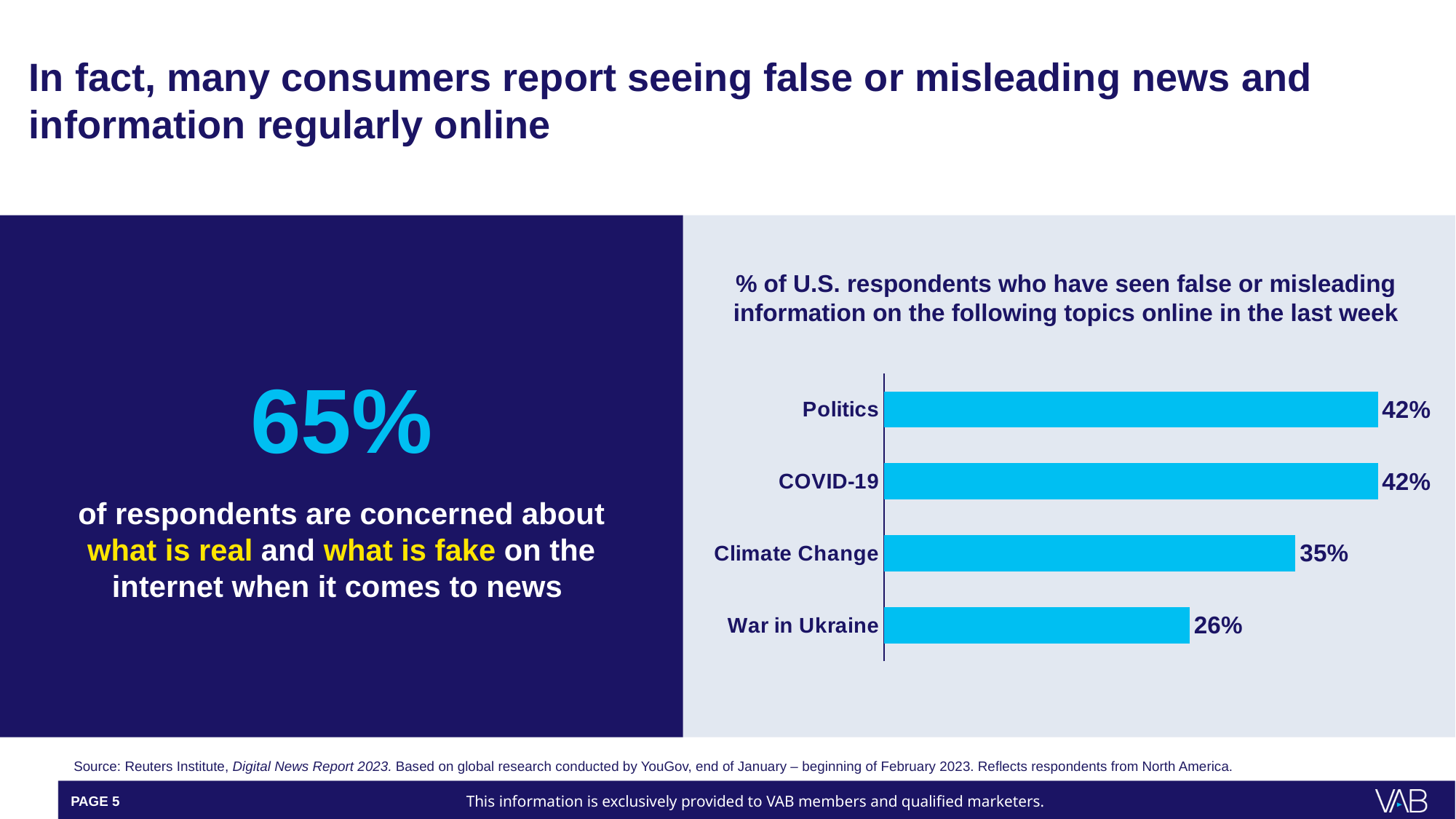
What is the difference between the values for Climate Change and War in Ukraine? 9% What is the title of the chart? % of U.S. respondents who have seen false or misleading information on the following topics online in the last week What is the value shown for COVID-19? 42% Which is larger, the value for Climate Change or the value for War in Ukraine? Climate Change What is the difference between the values for Politics and Climate Change? 7% What percentage of U.S. respondents have seen false or misleading information about Politics online in the last week? 42% Do the values rise or fall going from the top bar to the bottom bar? Fall What kind of chart is shown on the slide? Bar chart How many topics are shown in the chart? 4 Which topic has the lowest percentage of respondents who have seen false or misleading information? War in Ukraine What is the value shown for Climate Change? 35% What is the value shown for War in Ukraine? 26%